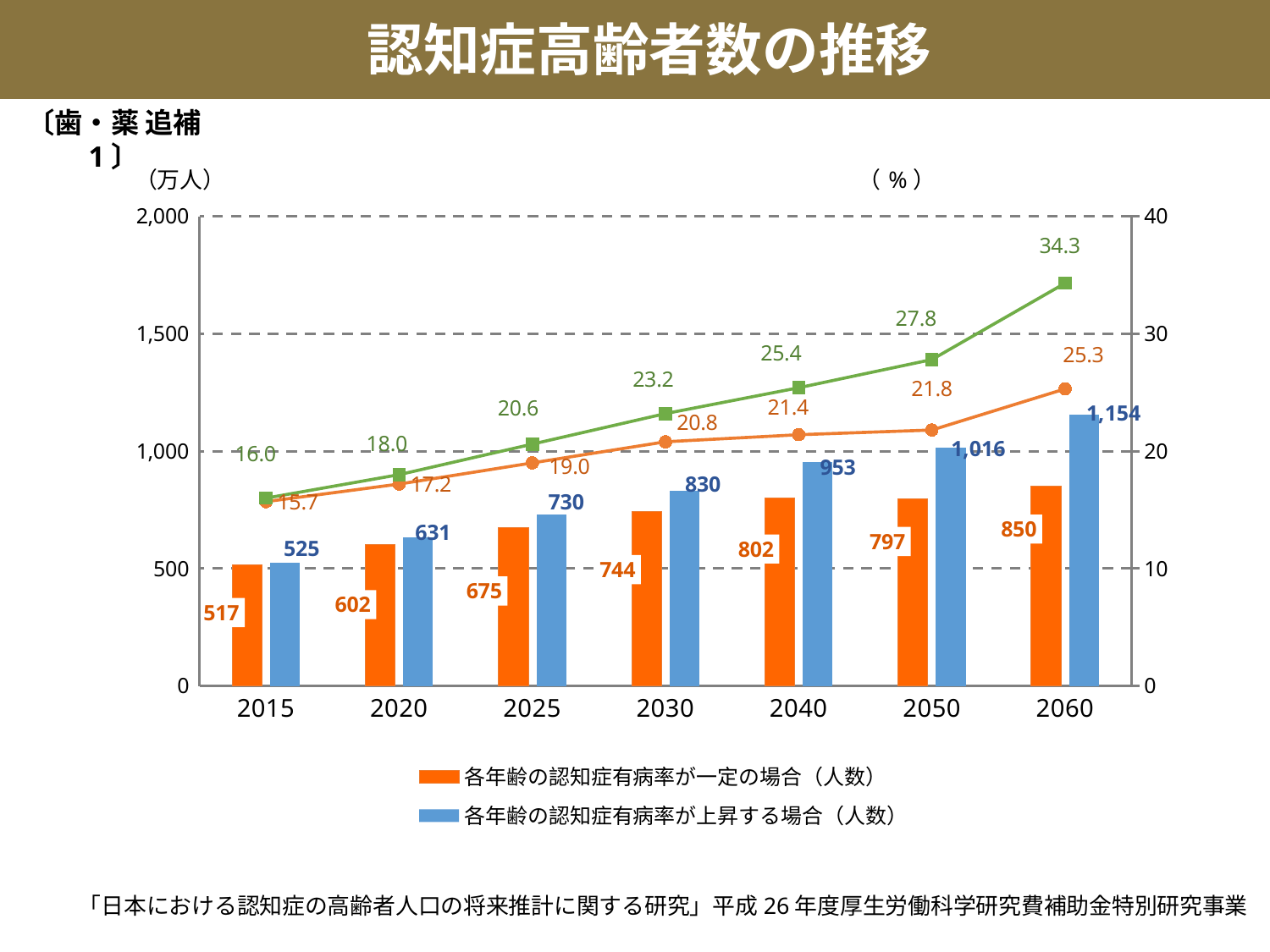
What is the value of the green line's data label for 2060? 34.3 What kind of chart is this? a combination bar and line chart How many years are shown on the x axis? 7 In which year is the orange bar (各年齢の認知症有病率が一定の場合) lowest? 2015 What is the value of the orange bar (各年齢の認知症有病率が一定の場合) for 2015? 517 What is the value of the orange bar (各年齢の認知症有病率が一定の場合) for 2040? 802 What is the difference between the blue bar and the orange bar in 2050? 219 What is the value of the blue bar (各年齢の認知症有病率が上昇する場合) for 2060? 1,154 Which is larger in 2030: the orange bar (一定の場合) or the blue bar (上昇する場合)? the blue bar (上昇する場合) Do the values of the green line rise or fall from 2015 to 2060? rise How many series does the legend list? 2 In which year is the blue bar (各年齢の認知症有病率が上昇する場合) highest? 2060